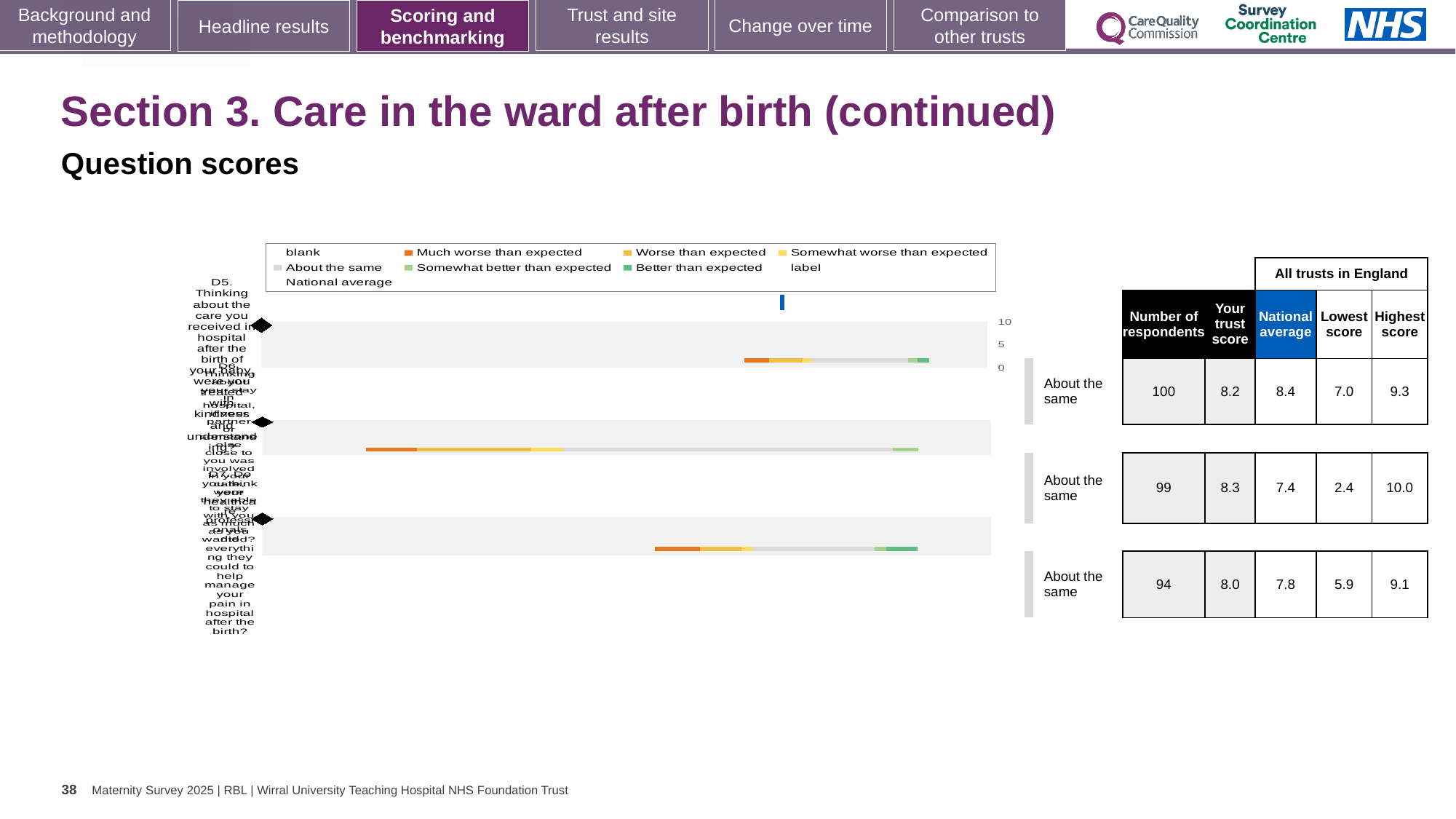
In the chart legend, which entry is shown in dark green? Better than expected For the second row of the table beside the chart, which is larger: the trust score or the national average? the trust score For the first row of the table beside the chart, what is the difference between the national average and the trust score? 0.2 In the chart legend, which entry is shown in dark orange? Much worse than expected In the table beside the chart, what is the 'Your trust score' value for the second row? 8.3 In the table beside the chart, what is the number of respondents for the first row? 100 In the table beside the chart, what is the lowest score for the second row? 2.4 What kind of chart is shown on the slide? bar chart How many question rows (bars) does the chart contain? 3 How many entries does the chart's legend list? 9 In the table beside the chart, what is the national average for the third row? 7.8 In the table beside the chart, what is the highest score for the second row? 10.0